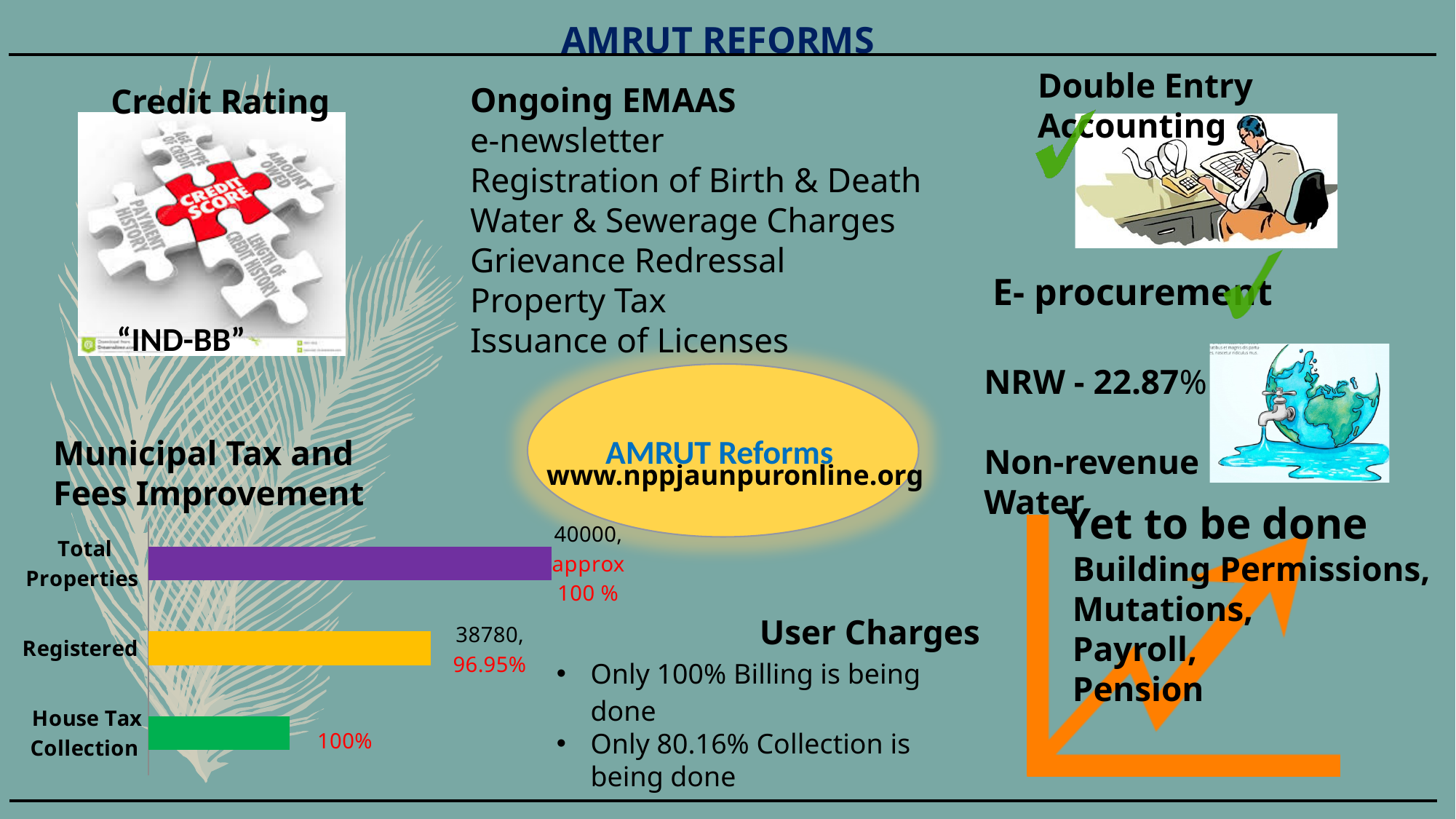
What is the difference between the Total Properties value and the Registered value in the Municipal Tax and Fees Improvement chart? 1220 Which category has the shortest bar in the Municipal Tax and Fees Improvement chart? House Tax Collection Which category has the longest bar in the Municipal Tax and Fees Improvement chart? Total Properties What percentage is shown next to the Registered bar in the Municipal Tax and Fees Improvement chart? 96.95% What type of chart is the Municipal Tax and Fees Improvement chart? Bar chart What value is labelled on the Total Properties bar in the Municipal Tax and Fees Improvement chart? 40000 What percentage is labelled on the House Tax Collection bar in the Municipal Tax and Fees Improvement chart? 100% What is the title of the bar chart on the slide? Municipal Tax and Fees Improvement How many categories are shown in the Municipal Tax and Fees Improvement chart? 3 In the Municipal Tax and Fees Improvement chart, which is larger: Total Properties or Registered? Total Properties What value is labelled on the Registered bar in the Municipal Tax and Fees Improvement chart? 38780 What colour is the Registered bar in the Municipal Tax and Fees Improvement chart? Yellow